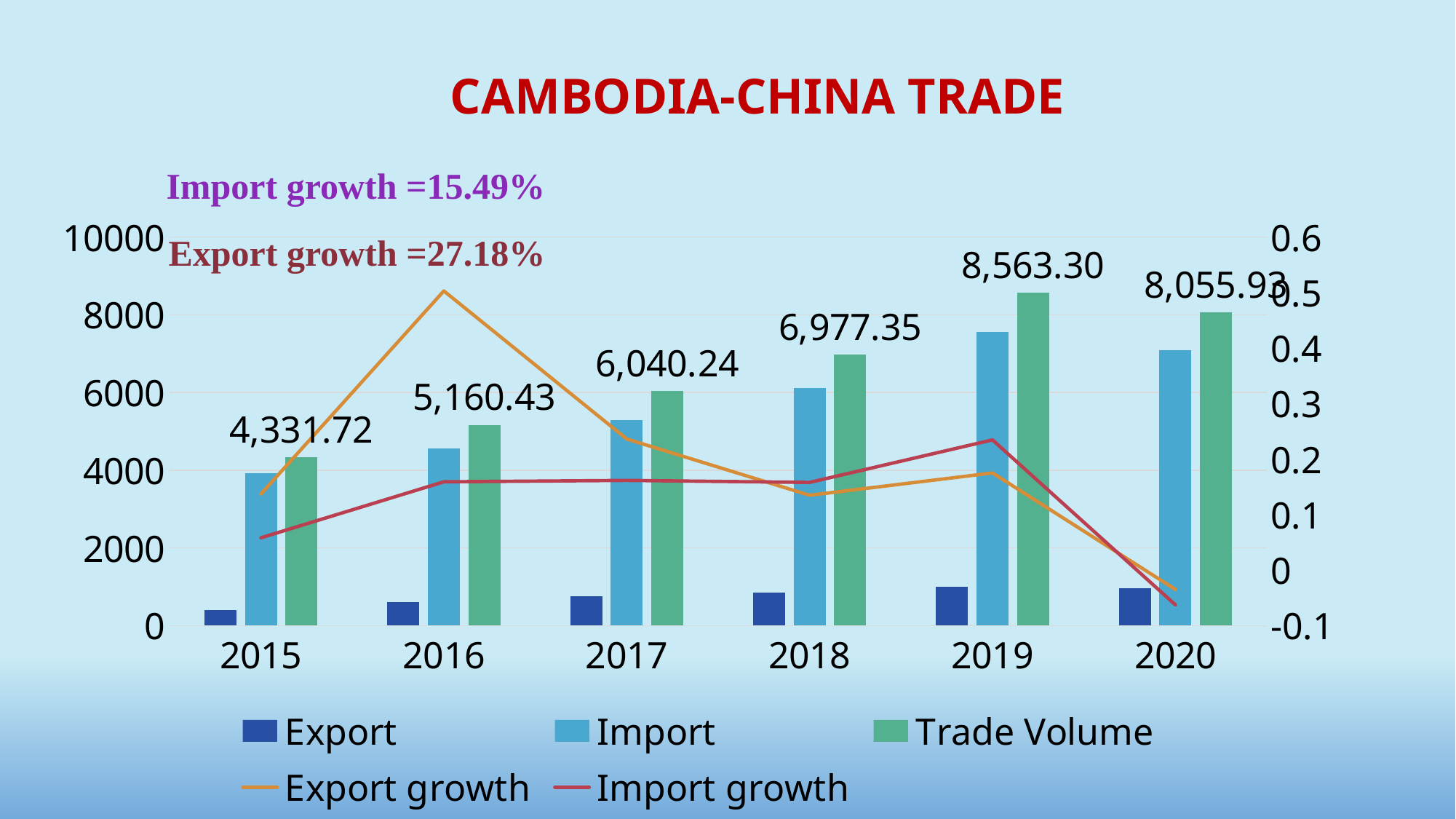
Does the Trade Volume rise or fall from 2015 to 2019? rise What is the Trade Volume value for 2018? 6,977.35 Which year has the highest Trade Volume? 2019 Is the Export value for 2019 greater or less than 2000? less What is the Trade Volume value for 2015? 4,331.72 How many years are shown on the x axis? 6 What is the difference between the Trade Volume in 2019 and in 2018? 1,585.95 How many series does the legend list? 5 Is the Import value for 2020 greater or less than 6000? greater Which year has the lowest Trade Volume? 2015 What is the difference between the Trade Volume in 2017 and in 2016? 879.81 Which year has the larger Import bar, 2018 or 2019? 2019